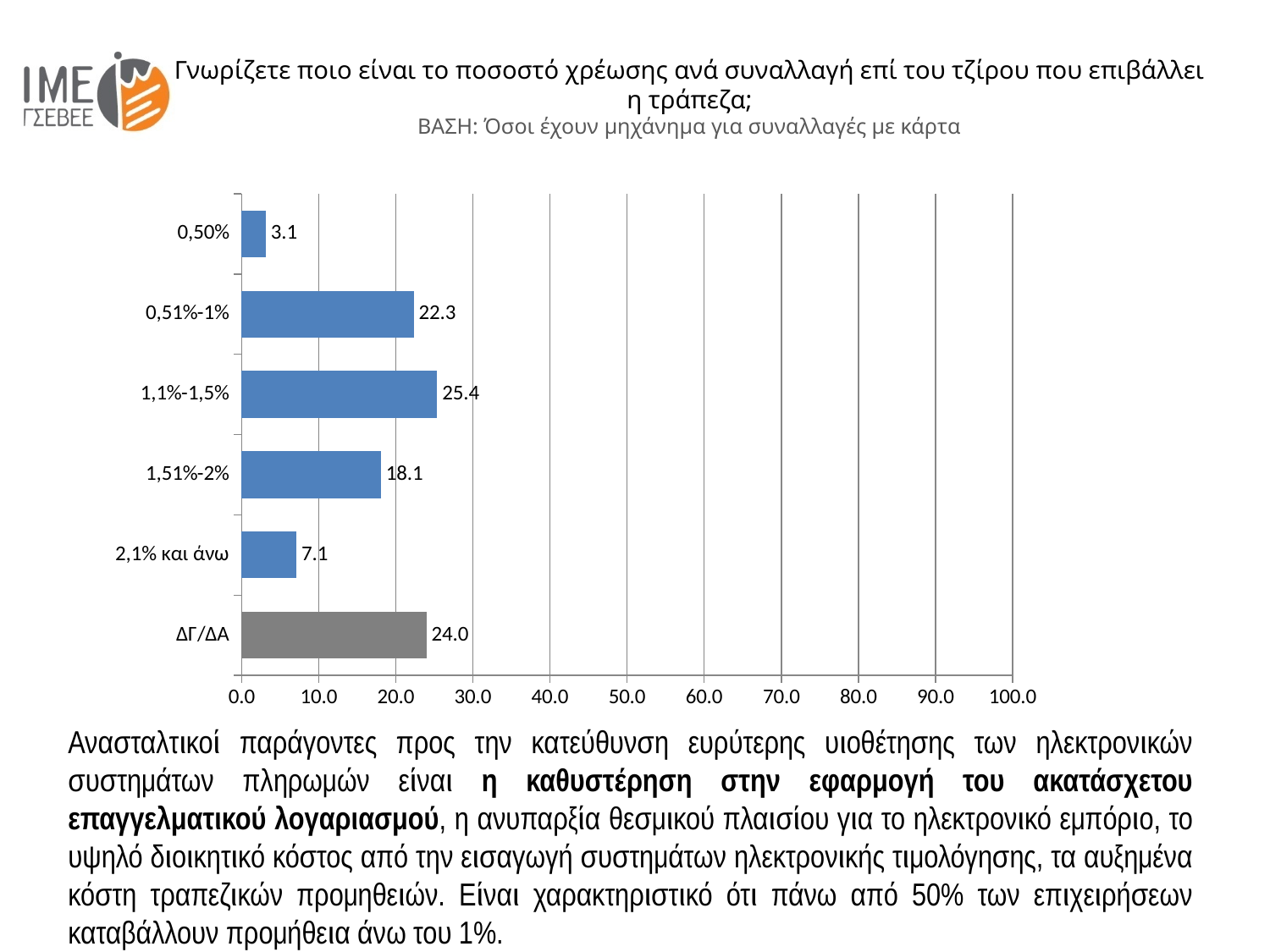
What is the difference between the values for "1,1%-1,5%" and "1,51%-2%"? 7.3 What kind of chart is shown on the slide? bar chart How many categories are shown in the chart? 6 What is the value for the category "0,51%-1%"? 22.3 Which category has the highest value? 1,1%-1,5% Which category has the lowest value? 0,50% Which category's bar is coloured grey rather than blue? ΔΓ/ΔΑ Is the value for "1,51%-2%" greater or less than 20.0? less Which is larger, the value for "0,51%-1%" or the value for "2,1% και άνω"? 0,51%-1% What is the value for the category "1,1%-1,5%"? 25.4 What is the value for the category "2,1% και άνω"? 7.1 What is the value for the category "ΔΓ/ΔΑ"? 24.0